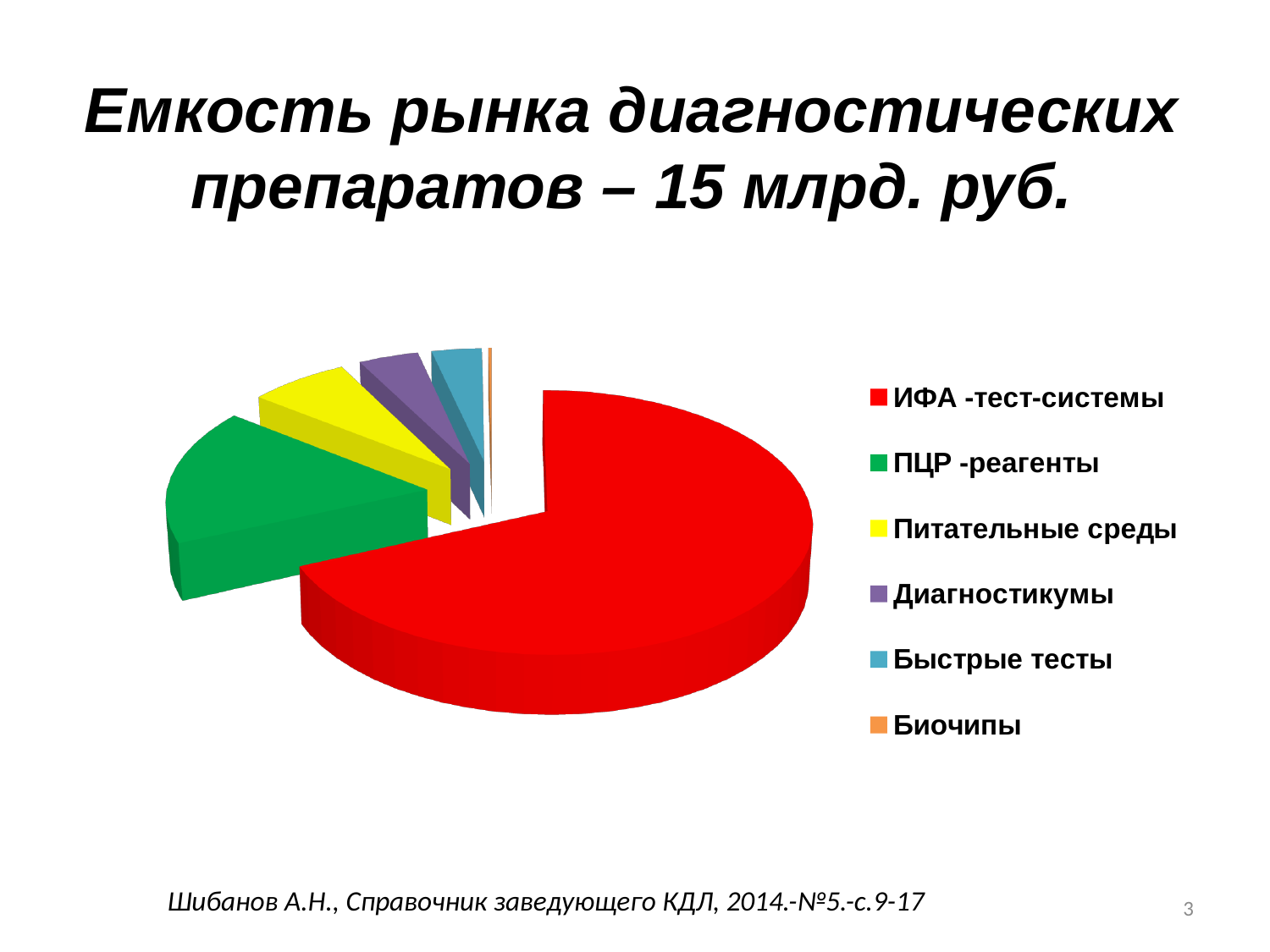
Which category has the smallest slice of the pie? Биочипы What is the title of the slide containing the pie chart? Емкость рынка диагностических препаратов – 15 млрд. руб. What colour is the slice for ИФА -тест-системы? red What kind of chart is shown on the slide? pie chart Which slice is larger: Питательные среды or Биочипы? Питательные среды Which category has the largest slice of the pie? ИФА -тест-системы Which slice is larger: ПЦР -реагенты or Питательные среды? ПЦР -реагенты Which slice is larger: ИФА -тест-системы or ПЦР -реагенты? ИФА -тест-системы Which category is the second largest slice of the pie? ПЦР -реагенты How many categories does the pie chart show? 6